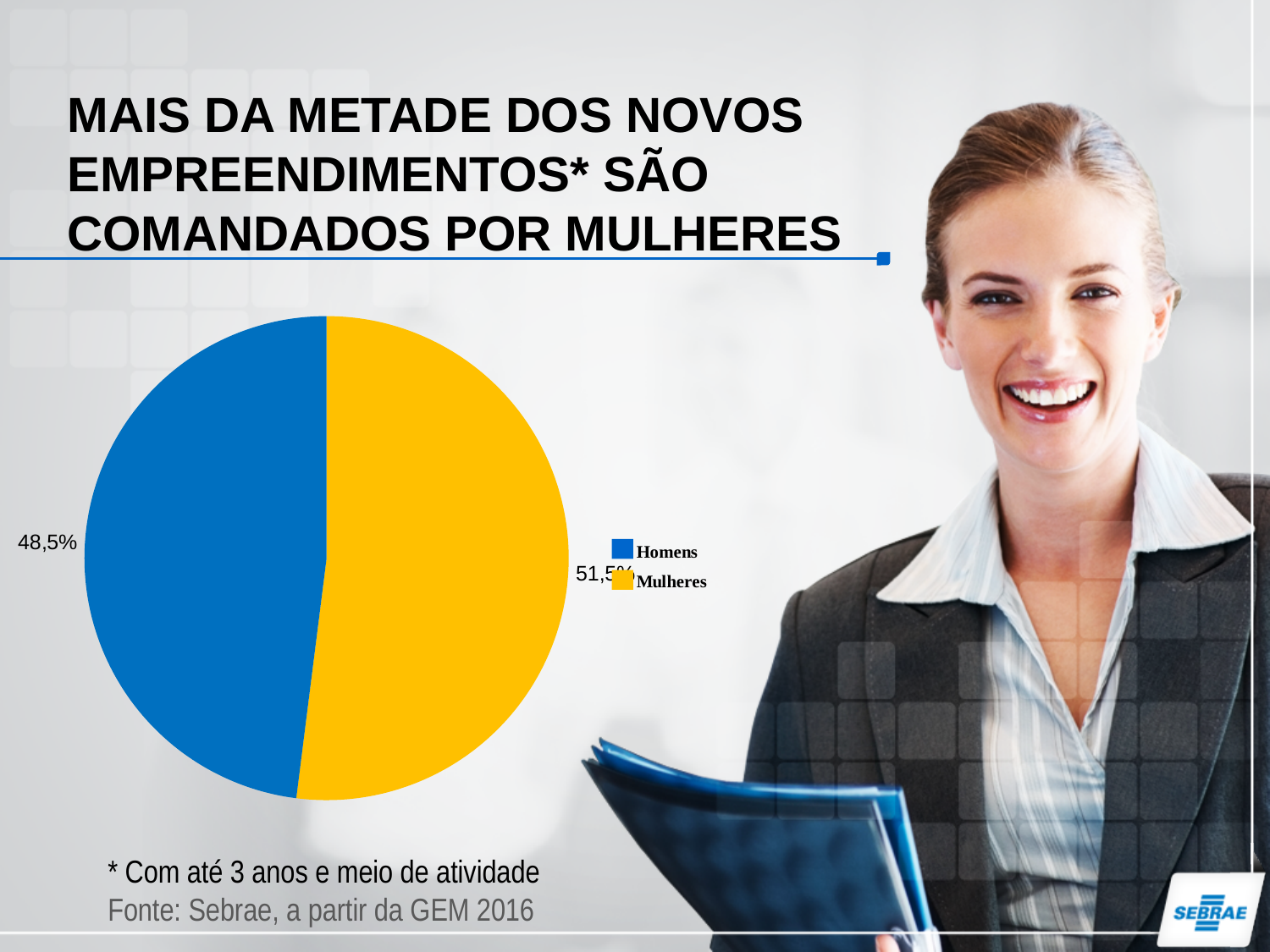
How many entries does the legend of the pie chart list? 2 What percentage of the pie chart corresponds to Mulheres? 51,5% Which category has the largest share of the pie chart? Mulheres What colour represents Mulheres in the pie chart? yellow Which slice of the pie chart is larger, Homens or Mulheres? Mulheres What is the difference in percentage points between the Mulheres and Homens slices? 3 percentage points What kind of chart is shown on the slide? pie chart Which category has the smallest share of the pie chart? Homens How many slices does the pie chart have? 2 What colour represents Homens in the pie chart? blue What percentage of the pie chart corresponds to Homens? 48,5%